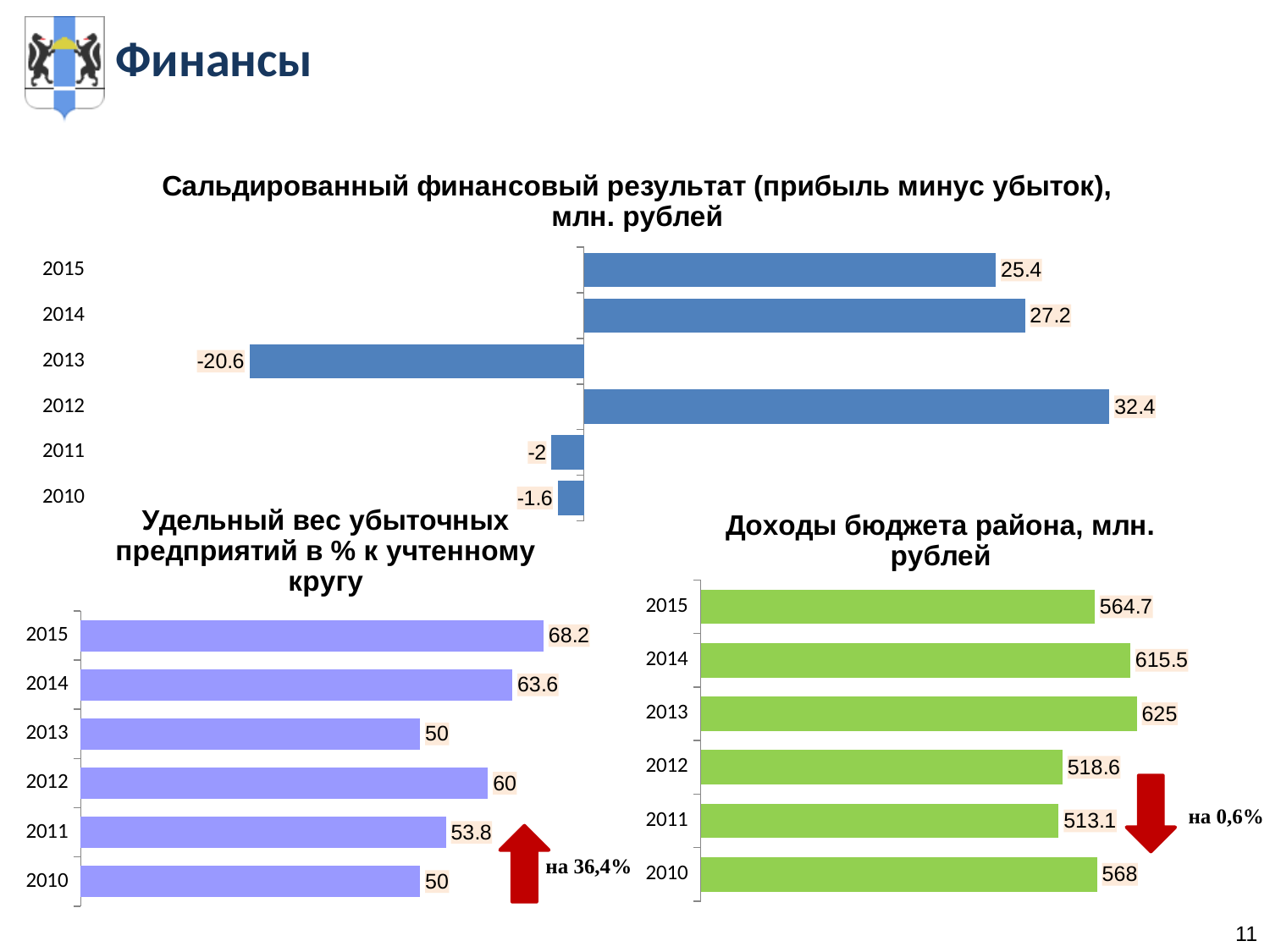
In the chart 'Удельный вес убыточных предприятий в % к учтенному кругу', which year has the highest value? 2015 In the chart 'Удельный вес убыточных предприятий в % к учтенному кругу', which is larger, the value for 2012 or the value for 2011? 2012 In the chart 'Доходы бюджета района, млн. рублей', which year has the highest value? 2013 What percentage change is written next to the red arrow beside the chart 'Удельный вес убыточных предприятий в % к учтенному кругу'? на 36,4% In the chart 'Сальдированный финансовый результат (прибыль минус убыток), млн. рублей', which year has the lowest value? 2013 In the chart 'Сальдированный финансовый результат (прибыль минус убыток), млн. рублей', what is the difference between the values for 2014 and 2015? 1.8 In the chart 'Доходы бюджета района, млн. рублей', what is the value for 2011? 513.1 In the chart 'Сальдированный финансовый результат (прибыль минус убыток), млн. рублей', how many years are shown? 6 In the chart 'Удельный вес убыточных предприятий в % к учтенному кругу', what is the value for 2014? 63.6 What type of chart is 'Доходы бюджета района, млн. рублей'? bar chart In the chart 'Сальдированный финансовый результат (прибыль минус убыток), млн. рублей', what is the value for 2012? 32.4 In the chart 'Доходы бюджета района, млн. рублей', what is the difference between the values for 2014 and 2015? 50.8